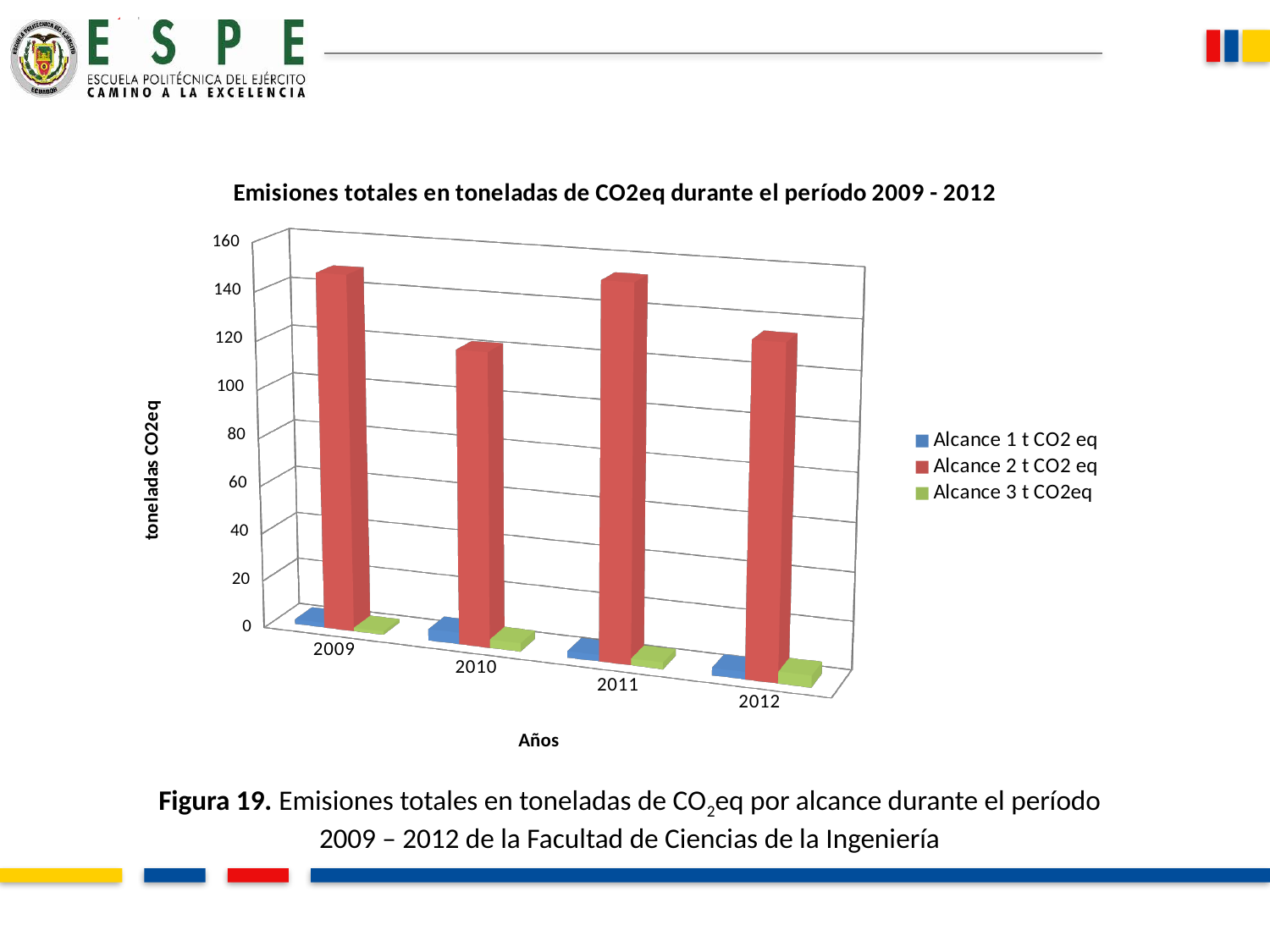
Is the value for Alcance 2 t CO2 eq in 2010 greater or less than 140? less Is the value for Alcance 2 t CO2 eq in 2011 greater or less than 120? greater Which is larger for Alcance 2 t CO2 eq, the value for 2009 or the value for 2010? 2009 How many series does the legend list? 3 What is the title of the chart? Emisiones totales en toneladas de CO2eq durante el período 2009 - 2012 How many years are shown on the x axis? 4 Is the value for Alcance 2 t CO2 eq in 2012 greater or less than 140? less What kind of chart is shown on the slide? bar chart Which is larger for Alcance 2 t CO2 eq, the value for 2011 or the value for 2012? 2011 Which series has the highest values in every year? Alcance 2 t CO2 eq What is the label of the vertical axis? toneladas CO2eq